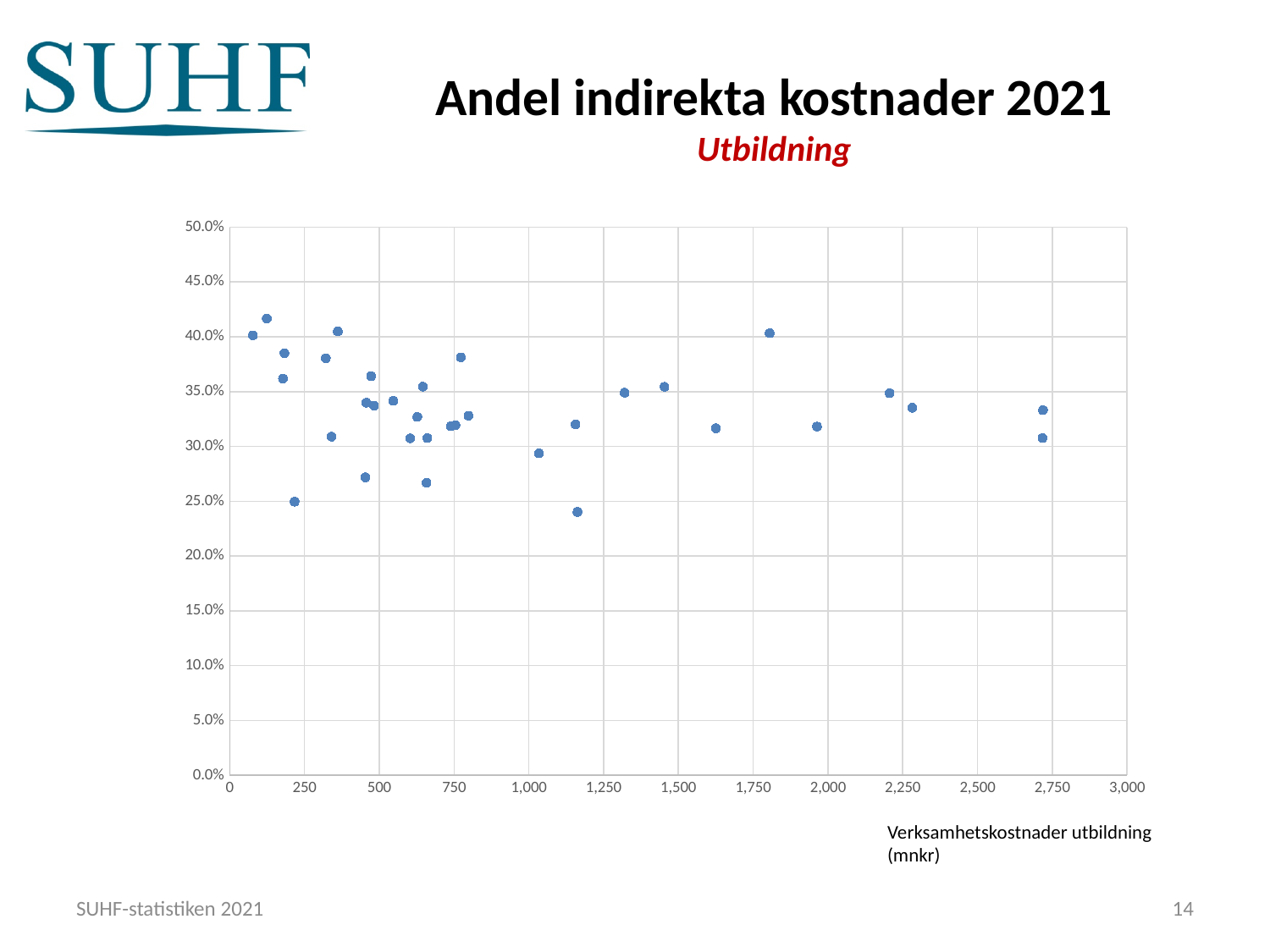
What is the title of the chart on the slide? Andel indirekta kostnader 2021 Is the value of the point plotted near 1,300 on the x axis greater or less than 30%? greater Are the two points plotted near 2,750 on the x axis greater or less than 35%? less Which has the higher value: the point plotted near 1,750 on the x axis or the point plotted near 2,000 on the x axis? The point near 1,750 What is the label of the x axis of the chart? Verksamhetskostnader utbildning (mnkr) What kind of chart is shown on the slide? Scatter chart Is the highest plotted value on the chart greater or less than 40%? greater